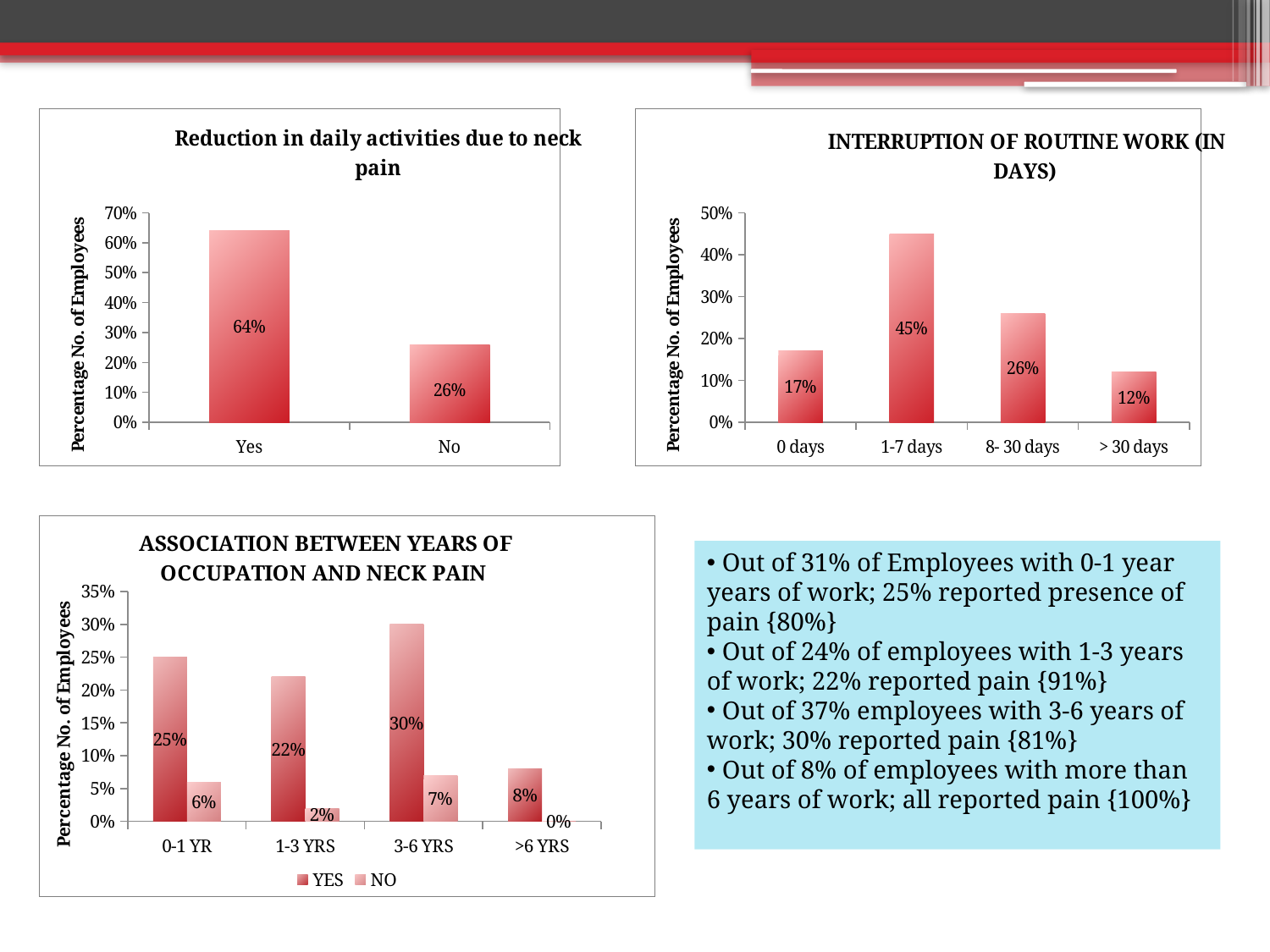
In the 'ASSOCIATION BETWEEN YEARS OF OCCUPATION AND NECK PAIN' chart, what is the NO value for 1-3 YRS? 2% In the 'INTERRUPTION OF ROUTINE WORK (IN DAYS)' chart, what is the value for 8- 30 days? 26% In the 'Reduction in daily activities due to neck pain' chart, what percentage of employees answered Yes? 64% In the 'INTERRUPTION OF ROUTINE WORK (IN DAYS)' chart, which category has the highest value? 1-7 days In the 'ASSOCIATION BETWEEN YEARS OF OCCUPATION AND NECK PAIN' chart, how many series does the legend list? 2 In the 'ASSOCIATION BETWEEN YEARS OF OCCUPATION AND NECK PAIN' chart, which is larger: the YES value for 0-1 YR or the YES value for 1-3 YRS? 0-1 YR In the 'ASSOCIATION BETWEEN YEARS OF OCCUPATION AND NECK PAIN' chart, what is the YES value for 3-6 YRS? 30% In the 'INTERRUPTION OF ROUTINE WORK (IN DAYS)' chart, which category has the lowest value? > 30 days In the 'ASSOCIATION BETWEEN YEARS OF OCCUPATION AND NECK PAIN' chart, what is the difference between the YES and NO values for 0-1 YR? 19% In the 'INTERRUPTION OF ROUTINE WORK (IN DAYS)' chart, how many categories are shown on the x axis? 4 What kind of chart is the 'Reduction in daily activities due to neck pain' chart? Bar chart In the 'Reduction in daily activities due to neck pain' chart, what is the difference between the Yes and No values? 38%